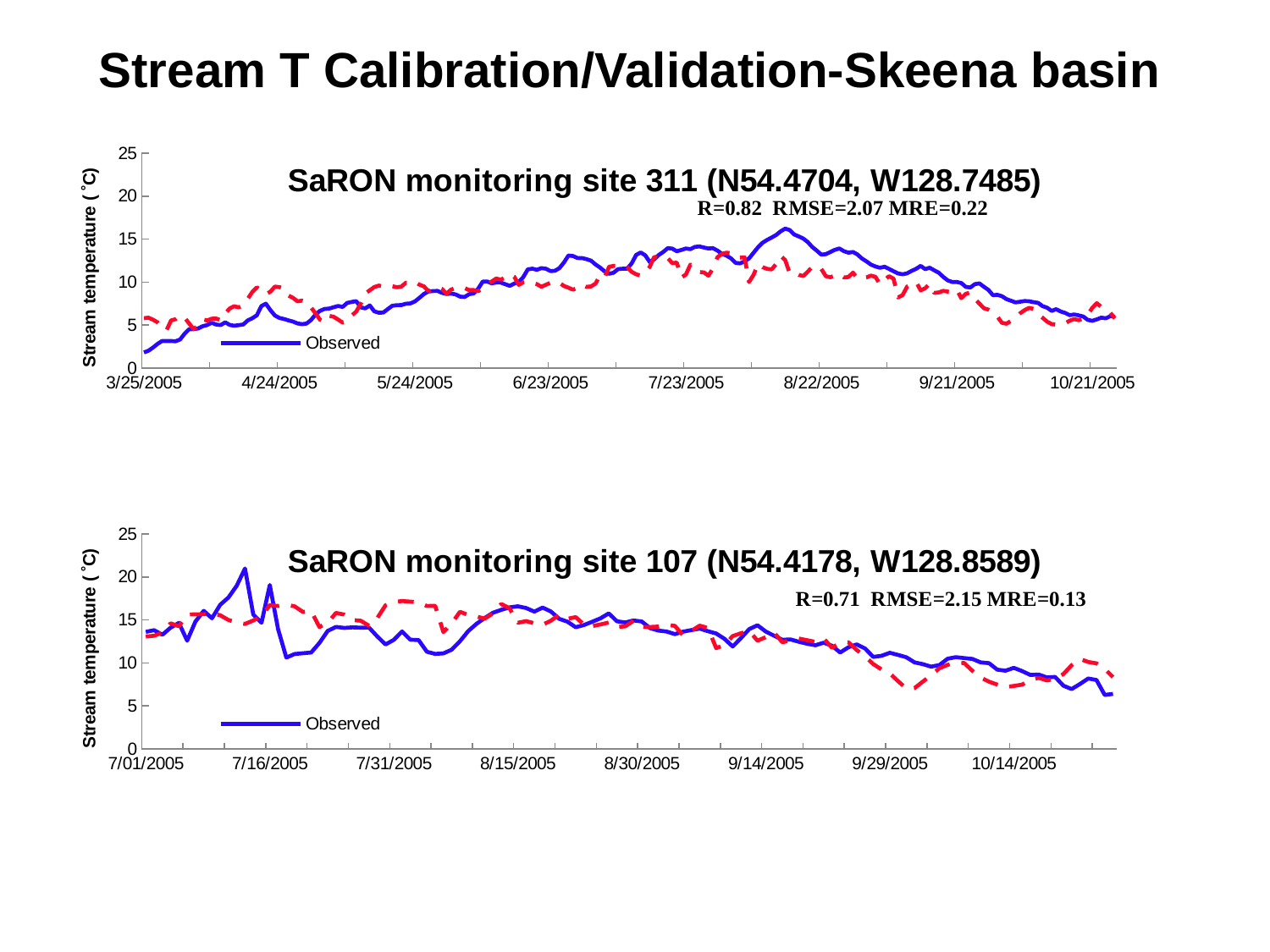
In the top chart (site 311), what is the label of the series shown in the legend? Observed In the top chart (site 311), does the Observed line generally rise or fall between 3/25/2005 and 7/23/2005? rise In the top chart (site 311), does the Observed line rise or fall between 8/22/2005 and 10/21/2005? fall In the bottom chart (site 107), is the Observed value at 7/01/2005 greater or less than 10? greater In the bottom chart (site 107), is the highest Observed value, near 7/16/2005, greater or less than 20? greater In the top chart (site 311), is the Observed value at 3/25/2005 greater or less than 5? less What kind of chart is the top chart, SaRON monitoring site 311? line chart What is the y-axis label on the bottom chart (site 107)? Stream temperature (°C) In the bottom chart (site 107), does the Observed line rise or fall from 8/15/2005 to the end of the series? fall Which chart reaches a higher peak Observed stream temperature, site 311 or site 107? site 107 In the top chart (site 311), how many series does the legend list? 1